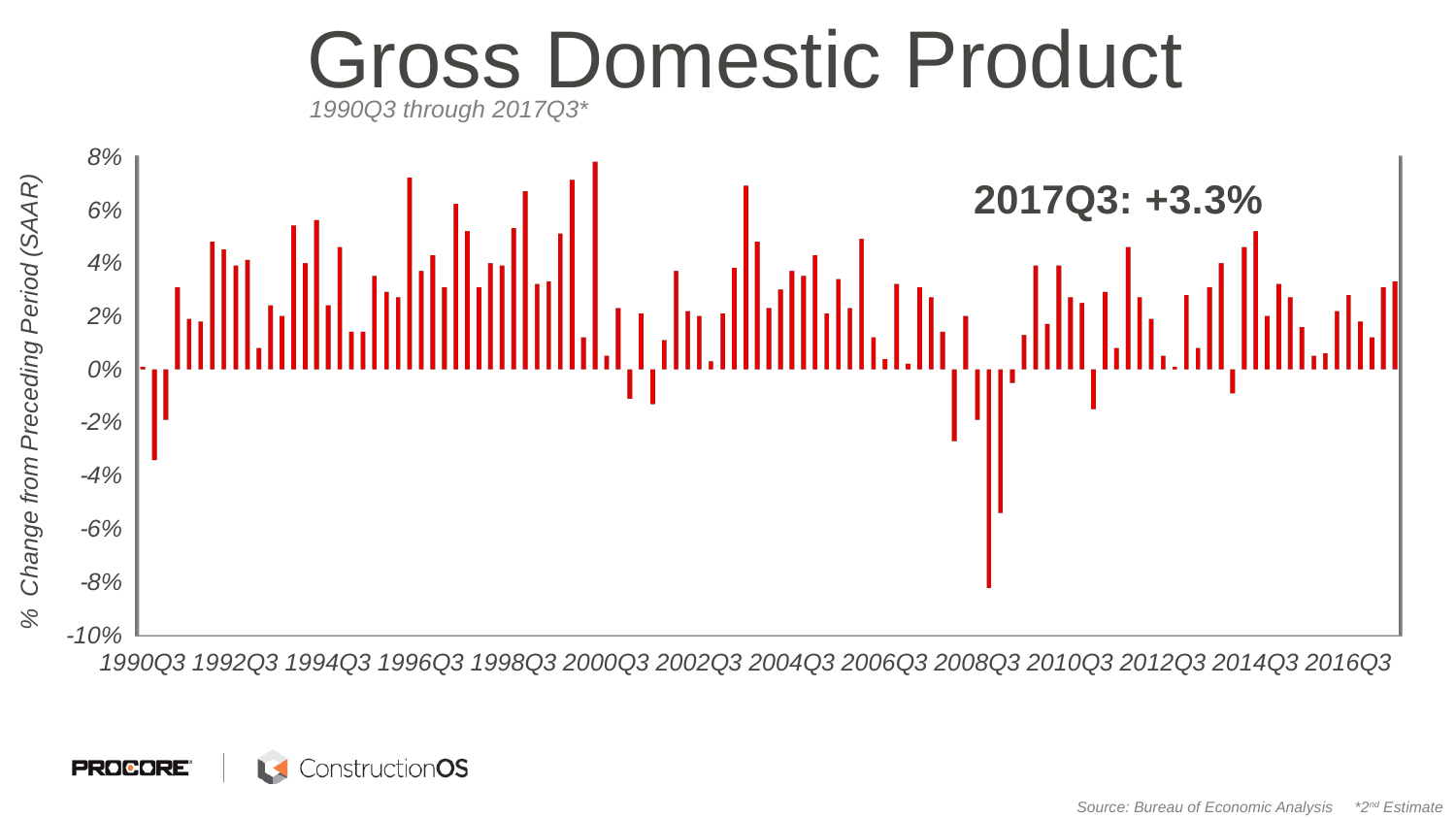
What kind of chart is shown on the slide? bar chart Is the value for 2017Q3 greater or less than 2%? greater What is the GDP % change value shown for 2017Q3? +3.3% How many x-axis tick labels are shown on the chart? 14 What is the title of the chart? Gross Domestic Product Is the value for 2017Q3 greater or less than 0%? greater What is the label on the y axis of the chart? % Change from Preceding Period (SAAR) Is the lowest value on the chart greater or less than -6%? less